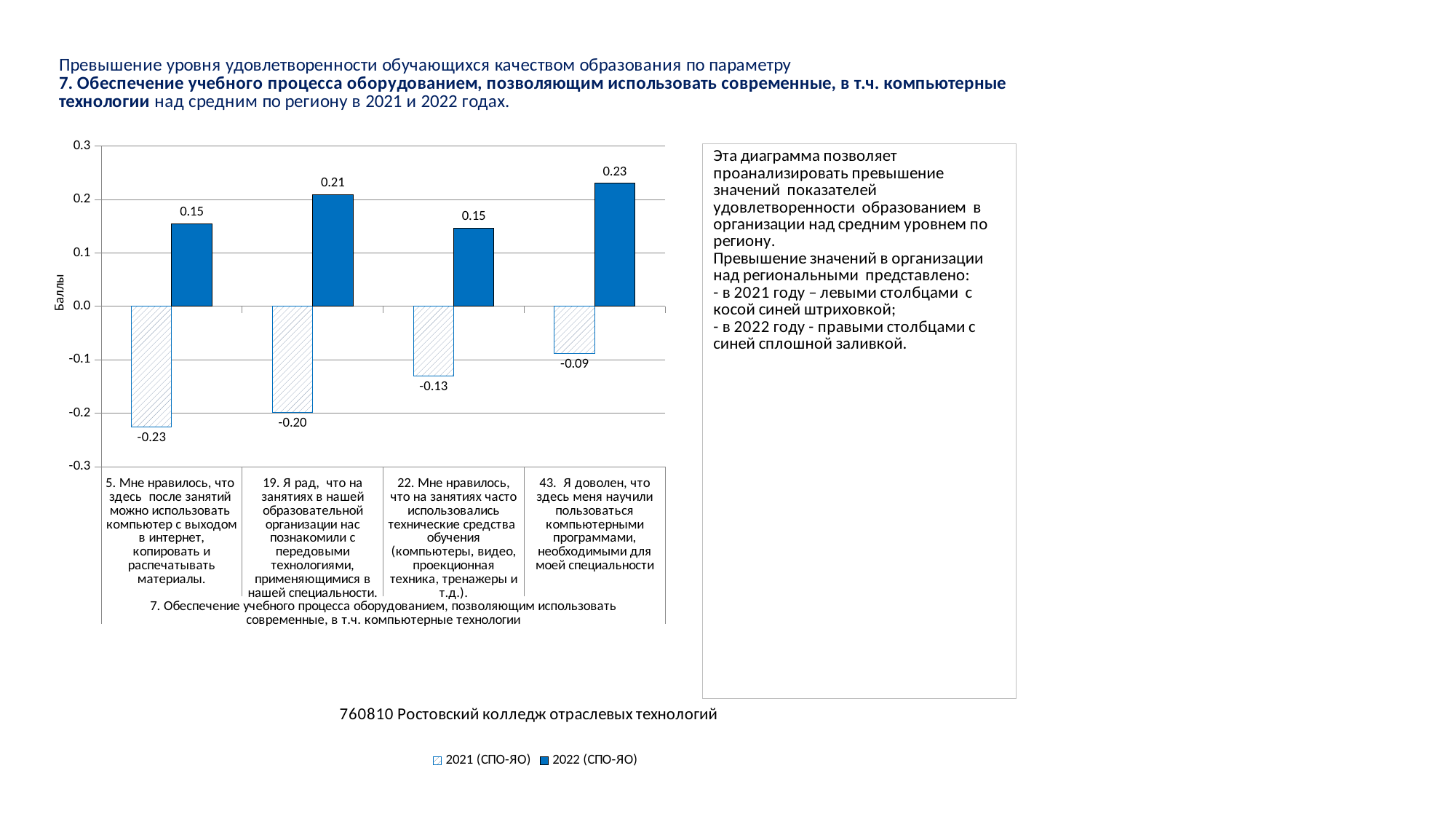
Значение серии 2021 (СПО-ЯО) по утверждению 43 больше или меньше -0.1? больше Какое значение показано для серии 2022 (СПО-ЯО) по утверждению 43 «Я доволен, что здесь меня научили пользоваться компьютерными программами, необходимыми для моей специальности»? 0.23 Какое значение показано для серии 2022 (СПО-ЯО) по утверждению 22 «Мне нравилось, что на занятиях часто использовались технические средства обучения»? 0.15 Какое значение больше: 2022 (СПО-ЯО) по утверждению 19 или 2022 (СПО-ЯО) по утверждению 22? 2022 (СПО-ЯО) по утверждению 19 По какому утверждению значение серии 2021 (СПО-ЯО) самое низкое? 5. Мне нравилось, что здесь после занятий можно использовать компьютер с выходом в интернет, копировать и распечатывать материалы. На сколько значение 2022 (СПО-ЯО) по утверждению 19 больше значения 2021 (СПО-ЯО) по тому же утверждению? 0.41 По какому утверждению значение серии 2022 (СПО-ЯО) самое высокое? 43. Я доволен, что здесь меня научили пользоваться компьютерными программами, необходимыми для моей специальности Сколько серий указано в легенде диаграммы? 2 Сколько утверждений (категорий) показано на диаграмме? 4 Какое значение показано для серии 2021 (СПО-ЯО) по утверждению 5 «Мне нравилось, что здесь после занятий можно использовать компьютер с выходом в интернет»? -0.23 Какое значение показано для серии 2021 (СПО-ЯО) по утверждению 19 «Я рад, что на занятиях в нашей образовательной организации нас познакомили с передовыми технологиями»? -0.20 Какого типа эта диаграмма? Столбчатая (bar chart)